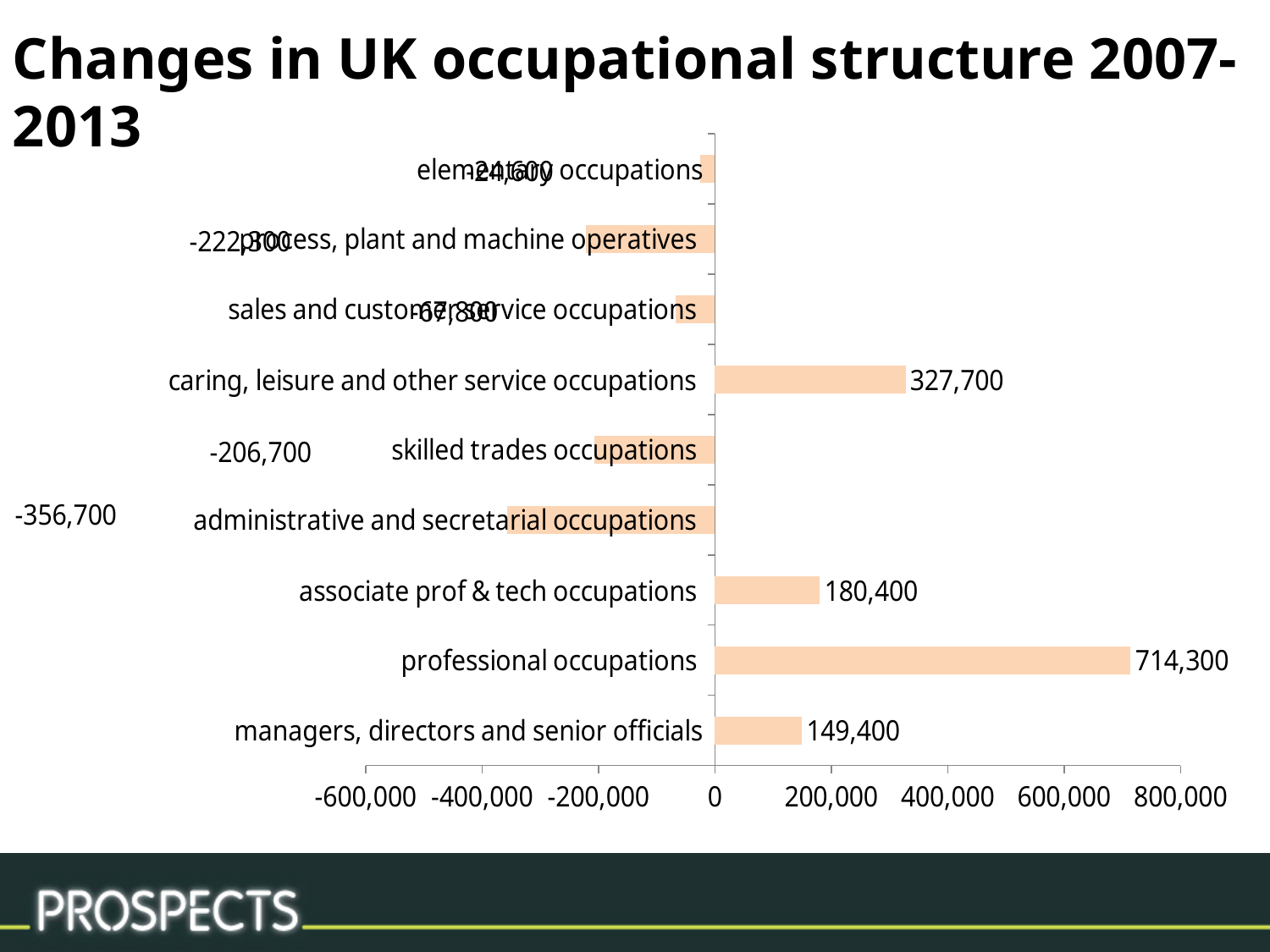
What is the value for managers, directors and senior officials? 149,400 Which is larger: the value for associate prof & tech occupations or for managers, directors and senior officials? associate prof & tech occupations What is the value for professional occupations? 714,300 How many occupation categories are plotted in the chart? 9 Which occupation category has the highest value in the chart? professional occupations Is the value for sales and customer service occupations greater or less than -200,000? greater What is the value for administrative and secretarial occupations? -356,700 What is the value for caring, leisure and other service occupations? 327,700 What kind of chart is shown on the slide? bar chart Which occupation category has the lowest value in the chart? administrative and secretarial occupations What is the value for skilled trades occupations? -206,700 What is the difference between the values for professional occupations and caring, leisure and other service occupations? 386,600